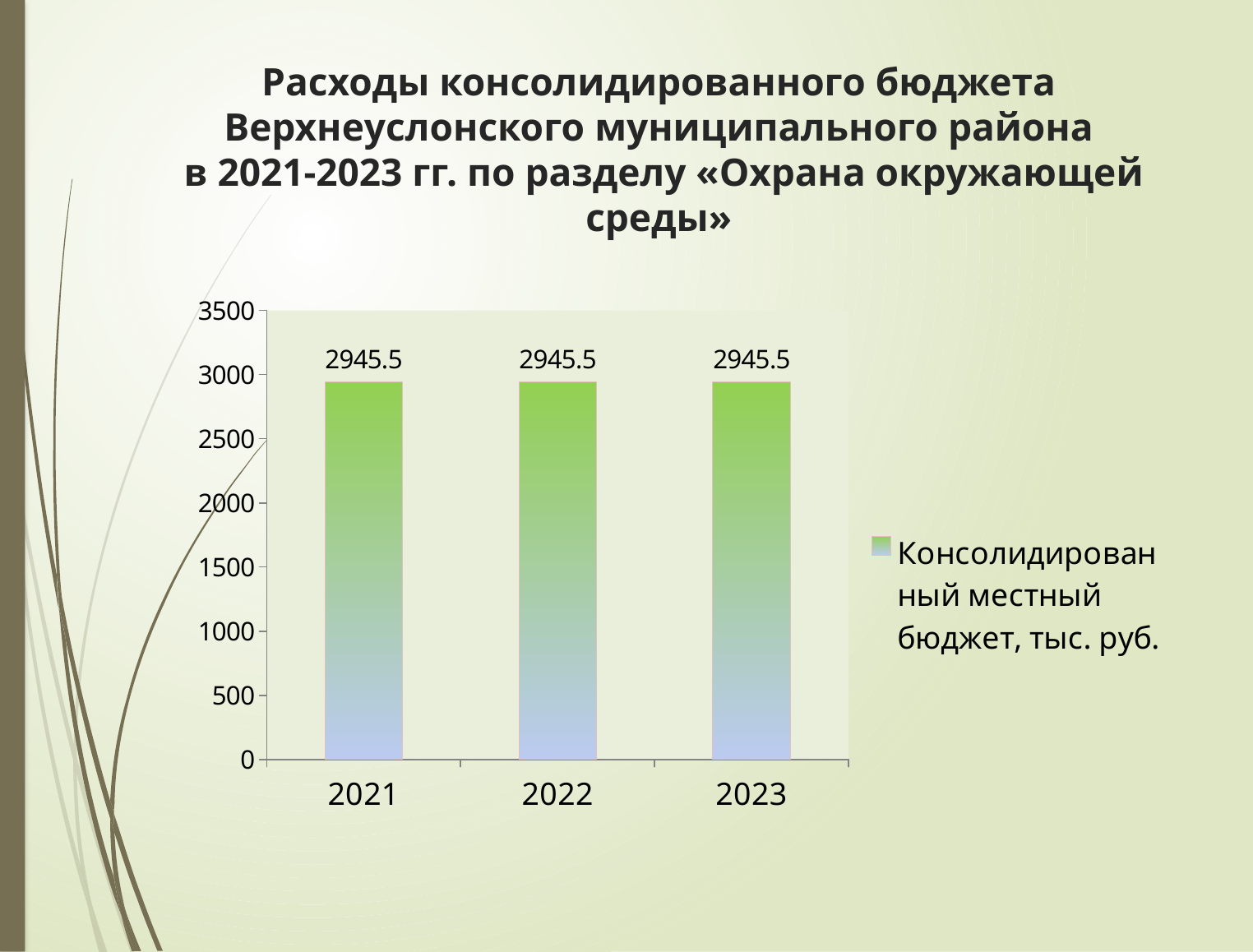
Do the values rise, fall or stay the same from 2021 to 2023? stay the same What is the value for 2023? 2945.5 How many series does the legend list? 1 What series name does the legend show? Консолидированный местный бюджет, тыс. руб. What is the difference between the values for 2023 and 2021? 0 What is the value for 2022? 2945.5 How many years are shown on the x axis? 3 Is the value for 2021 larger than, smaller than, or equal to the value for 2022? equal What kind of chart is shown on the slide? bar chart What is the value for 2021? 2945.5 Is the value for 2022 greater or less than 2500? greater Is the value for 2023 greater or less than 3000? less